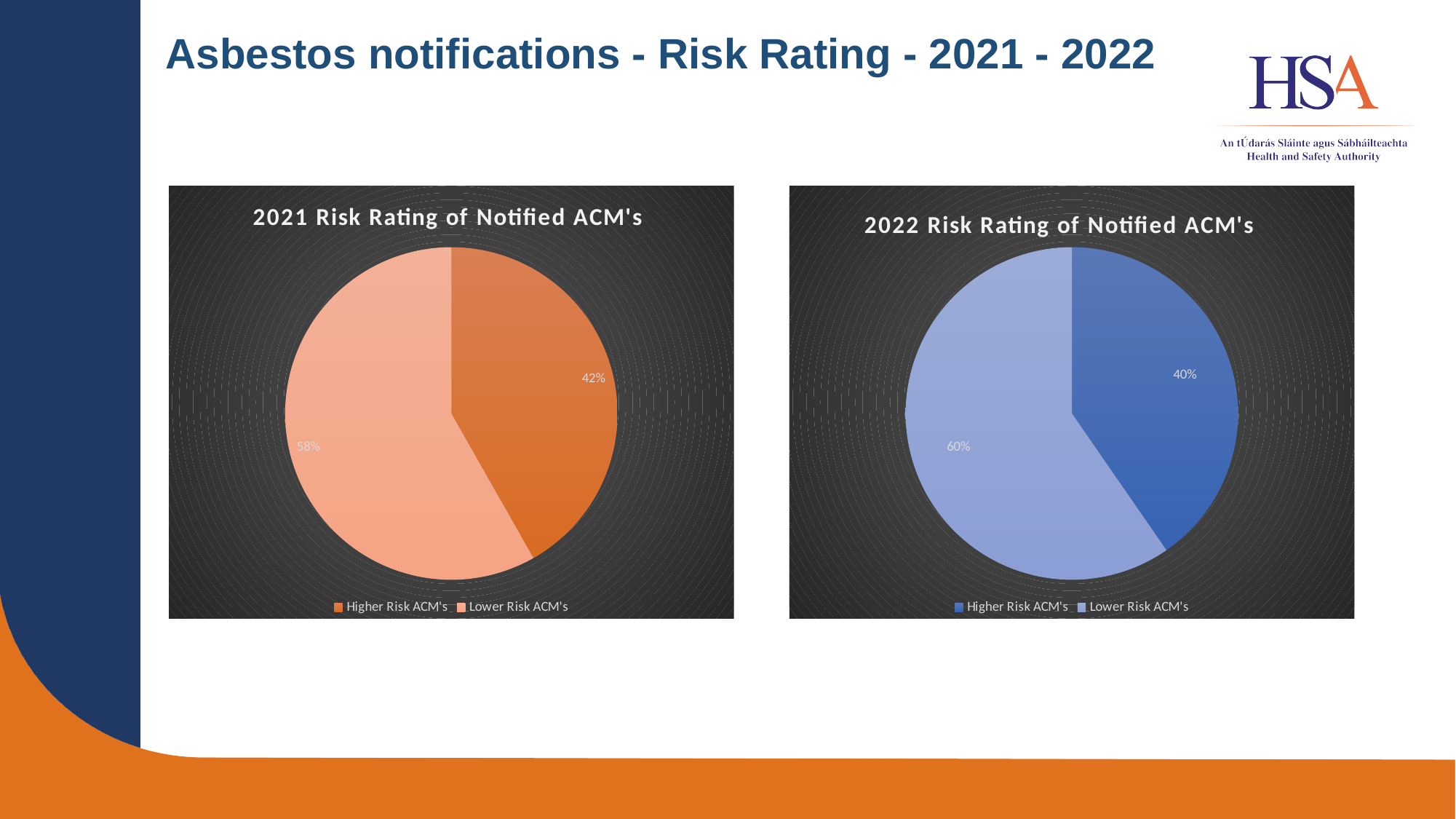
What is the title of the chart on the left of the slide? 2021 Risk Rating of Notified ACM's In the 2022 Risk Rating of Notified ACM's chart, what is the difference in percentage points between Lower Risk ACM's and Higher Risk ACM's? 20 percentage points What type of chart is the 2022 Risk Rating of Notified ACM's chart? Pie chart In the 2021 Risk Rating of Notified ACM's chart, what is the difference in percentage points between Lower Risk ACM's and Higher Risk ACM's? 16 percentage points How many categories does the 2021 Risk Rating of Notified ACM's chart show? 2 In the 2022 Risk Rating of Notified ACM's chart, what share of notified ACM's were Higher Risk ACM's? 40% In the 2021 Risk Rating of Notified ACM's chart, what share of notified ACM's were Higher Risk ACM's? 42% Which is larger: the Higher Risk ACM's share in the 2021 chart or the Higher Risk ACM's share in the 2022 chart? 2021 chart In the 2021 Risk Rating of Notified ACM's chart, what share of notified ACM's were Lower Risk ACM's? 58% In the 2022 Risk Rating of Notified ACM's chart, which category has the smallest slice? Higher Risk ACM's In the 2021 Risk Rating of Notified ACM's chart, which category has the largest slice? Lower Risk ACM's In the 2022 Risk Rating of Notified ACM's chart, what share of notified ACM's were Lower Risk ACM's? 60%